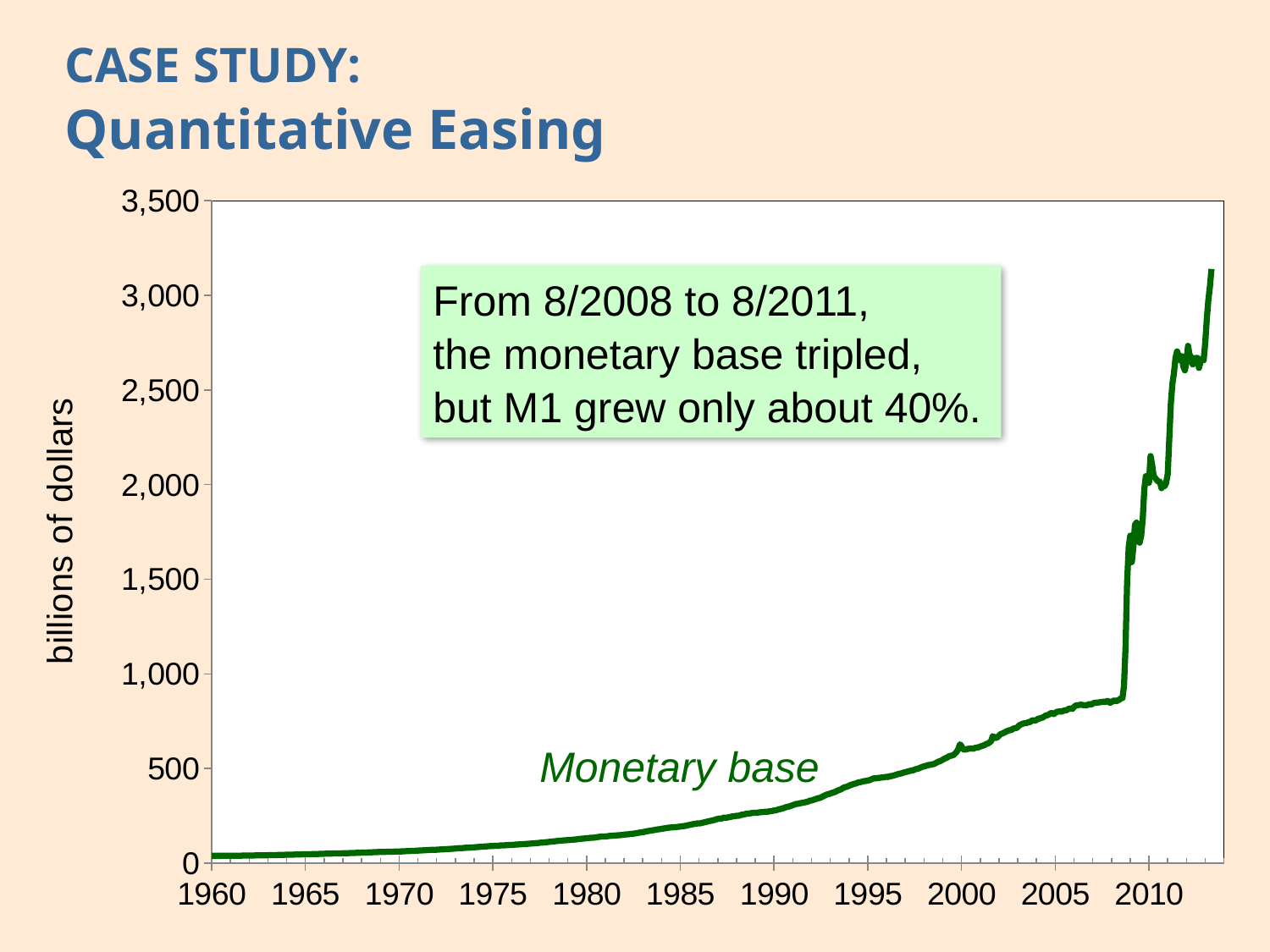
Is the value of the monetary base in 2005 greater or less than 1,000? less Is the value of the monetary base in 2010 greater or less than 1,500? greater What series is plotted on the chart? Monetary base How many year labels are shown on the horizontal axis? 11 Is the value of the monetary base in 1980 greater or less than 500? less Which is larger, the monetary base in 2010 or in 2000? 2010 What kind of chart is shown on the slide? line chart What is the label on the vertical axis of the chart? billions of dollars Does the monetary base generally rise or fall from 1960 to the end of the period shown? rise